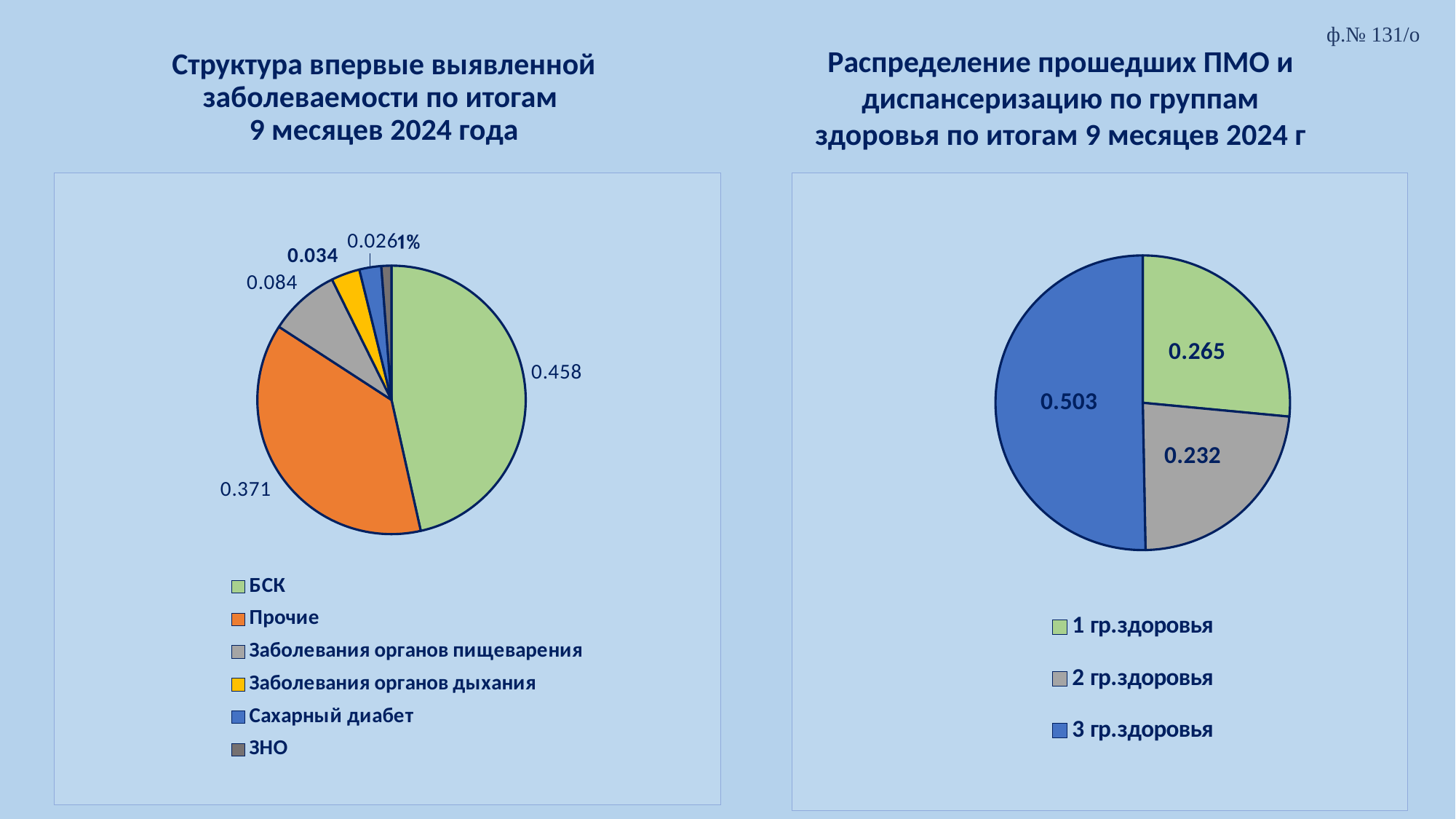
In the left chart (Структура впервые выявленной заболеваемости), what is the difference between the values for БСК and Прочие? 0.087 In the right chart (Распределение прошедших ПМО и диспансеризацию по группам здоровья), which colour represents 2 гр.здоровья? Grey In the left chart (Структура впервые выявленной заболеваемости), how many categories does the legend list? 6 In the left chart (Структура впервые выявленной заболеваемости), which category has the largest slice? БСК What type of chart is the left chart (Структура впервые выявленной заболеваемости)? Pie chart In the right chart (Распределение прошедших ПМО и диспансеризацию по группам здоровья), what is the value for 3 гр.здоровья? 0.503 In the left chart (Структура впервые выявленной заболеваемости), what is the value for Прочие? 0.371 In the right chart (Распределение прошедших ПМО и диспансеризацию по группам здоровья), what is the difference between the values for 3 гр.здоровья and 1 гр.здоровья? 0.238 In the left chart (Структура впервые выявленной заболеваемости), what is the value for БСК? 0.458 In the left chart (Структура впервые выявленной заболеваемости), what is the value for Заболевания органов пищеварения? 0.084 In the right chart (Распределение прошедших ПМО и диспансеризацию по группам здоровья), which health group has the smallest slice? 2 гр.здоровья In the right chart (Распределение прошедших ПМО и диспансеризацию по группам здоровья), what is the value for 1 гр.здоровья? 0.265